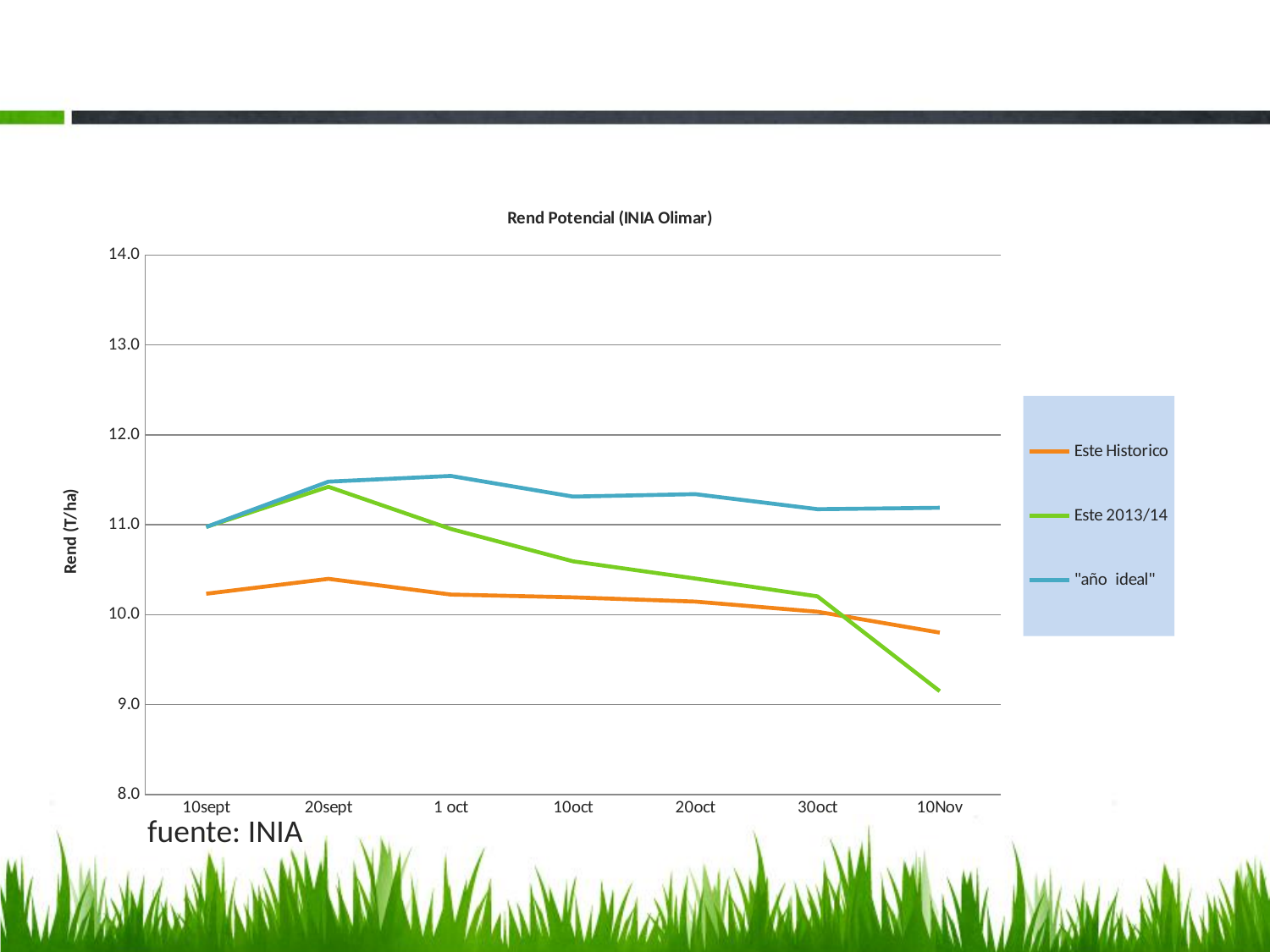
How many series does the legend list? 3 Does the Este 2013/14 line rise or fall from 20sept to 10Nov? fall Is the value for Este Historico at 20sept greater or less than 11.0? less Is the value for Este 2013/14 at 10Nov greater or less than 10.0? less At 1 oct, which series has the higher value, "año ideal" or Este Historico? "año ideal" How many dates are shown along the x axis? 7 What is the title of the chart? Rend Potencial (INIA Olimar) What kind of chart is shown on the slide? line chart At 10Nov, which series has the higher value, Este Historico or Este 2013/14? Este Historico Which series has the lowest value at 10Nov? Este 2013/14 Is the value for "año ideal" at 1 oct greater or less than 11.0? greater Which series has the highest value at 10oct? "año ideal"